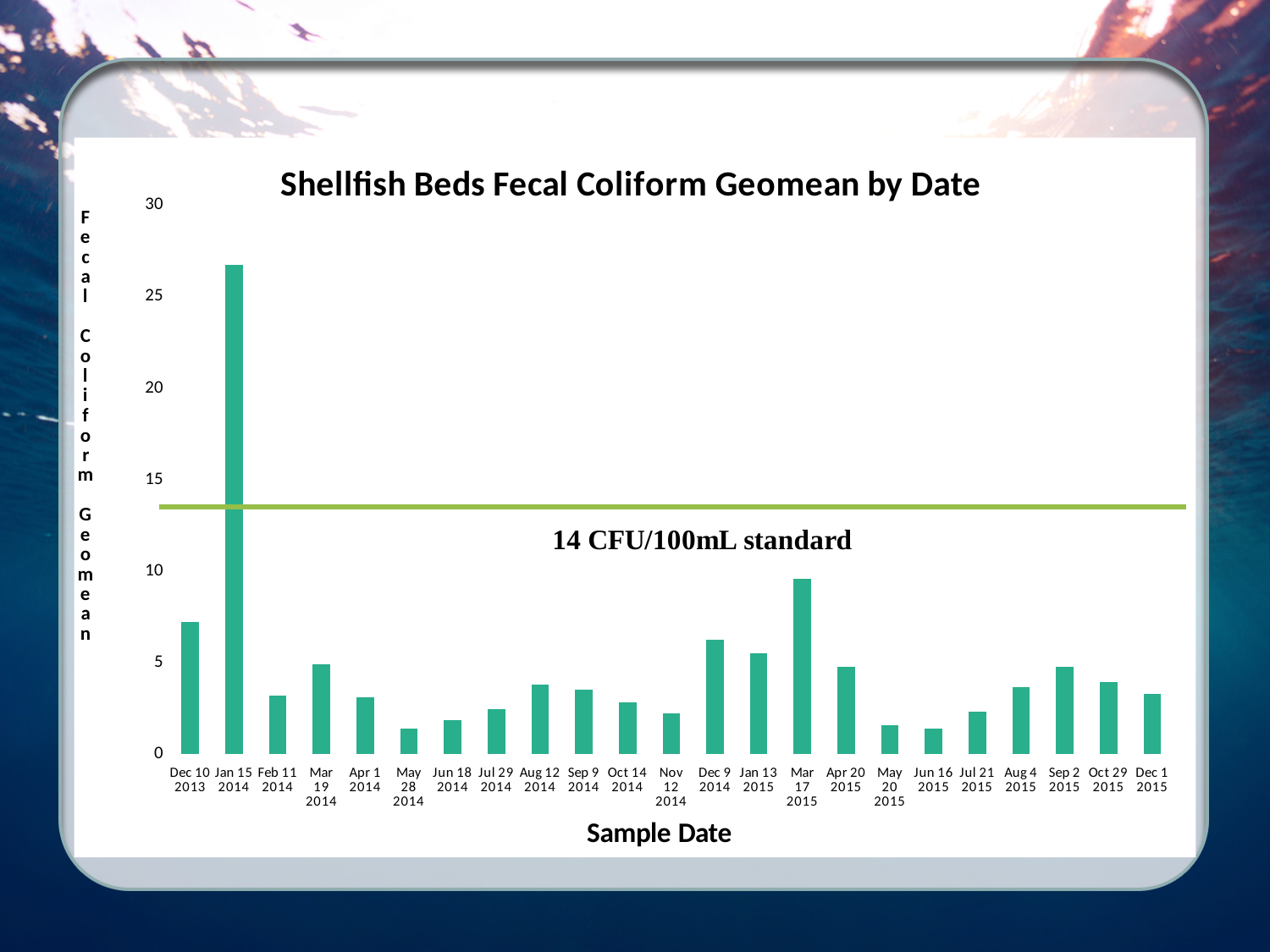
How many sample dates are plotted on the chart? 23 Which sample date has the highest fecal coliform geomean? Jan 15 2014 Which has a higher value, Mar 17 2015 or Apr 20 2015? Mar 17 2015 Is the value for Feb 11 2014 greater or less than 5? less Which has a higher value, Dec 10 2013 or Mar 17 2015? Mar 17 2015 How many bars exceed the 14 CFU/100mL standard line? 1 Is the value for Mar 17 2015 greater or less than 10? less What is the label of the horizontal axis? Sample Date What is the title of the chart? Shellfish Beds Fecal Coliform Geomean by Date Is the value for Dec 10 2013 greater or less than 5? greater What type of chart is shown on the slide? bar chart